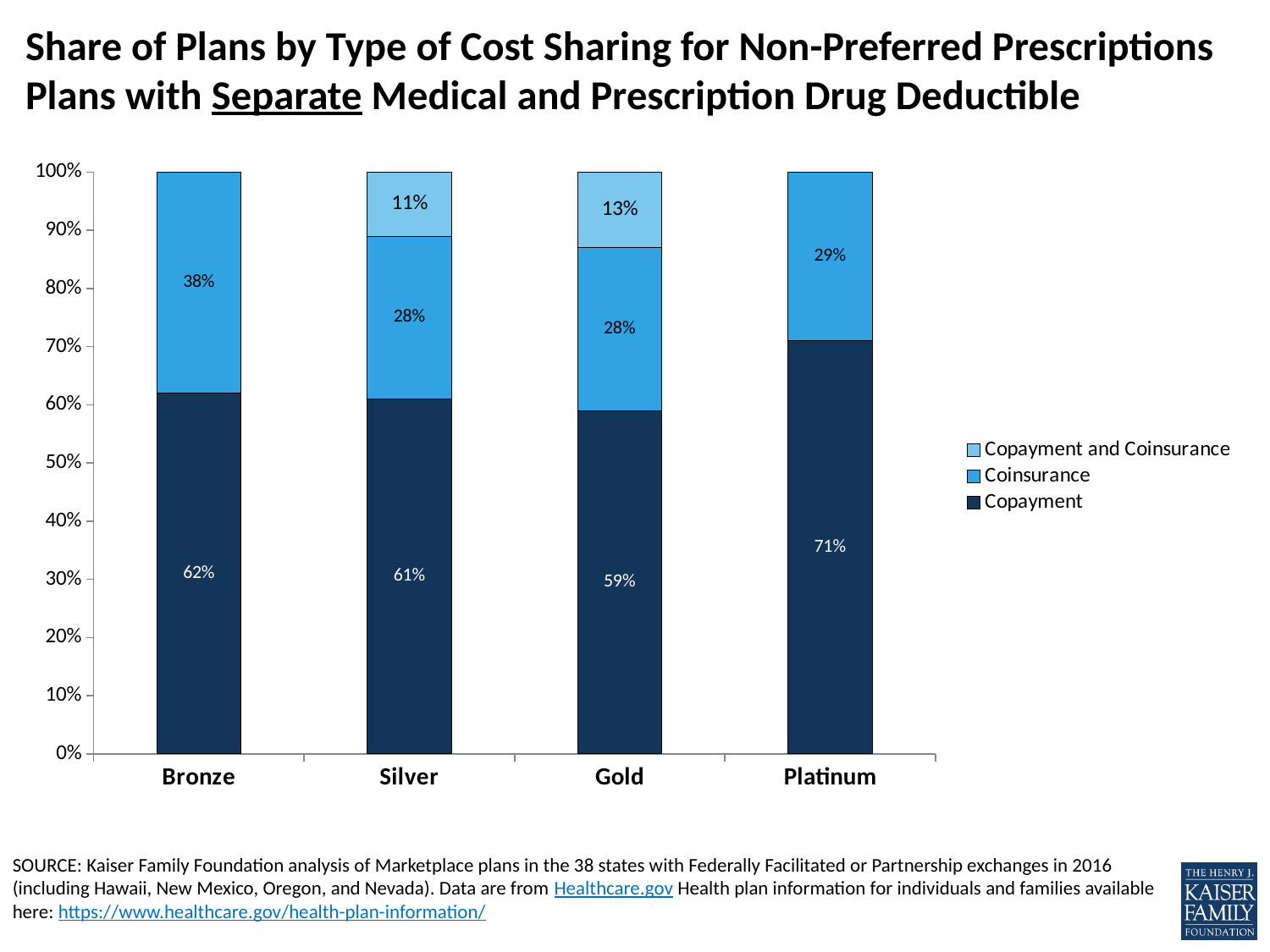
What kind of chart is shown on the slide? Stacked bar chart What share of Gold plans use Copayment and Coinsurance? 13% What share of Bronze plans use Copayment for non-preferred prescriptions? 62% Which legend entry is shown in the darkest blue colour? Copayment Which is larger: the Coinsurance share for Bronze or for Silver? Bronze Which metal level has the highest share of plans using Copayment? Platinum What share of Platinum plans use Coinsurance? 29% How many metal levels are shown on the x axis? 4 What share of Silver plans use Copayment and Coinsurance? 11% How many series does the legend list? 3 Which metal level has the lowest share of plans using Copayment? Gold How many percentage points higher is the Copayment share for Platinum than for Bronze? 9 percentage points